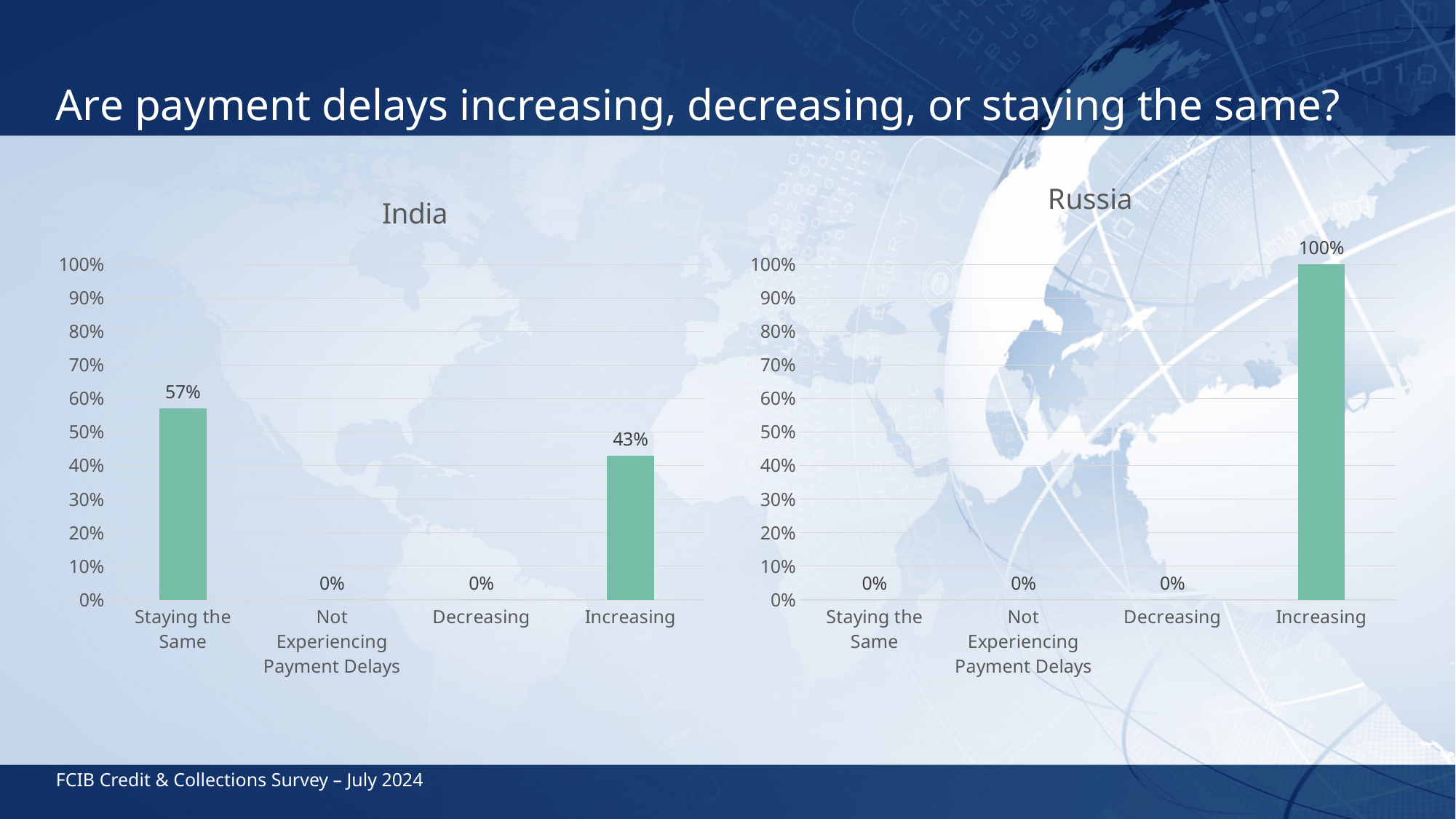
In the Russia chart, what is the value for Decreasing? 0% In the Russia chart, which category has the highest value? Increasing In the Russia chart, what is the value for Increasing? 100% How many categories are shown on the x axis of the Russia chart? 4 What is the title of the chart on the right side of the slide? Russia What kind of chart is the India chart? bar chart In the India chart, what is the value for Increasing? 43% In the India chart, which category has the highest value? Staying the Same In the India chart, is the value for Increasing greater or less than 50%? less In the India chart, which is larger, Staying the Same or Increasing? Staying the Same In the India chart, what is the difference between Staying the Same and Increasing? 14% In the India chart, what is the value for Staying the Same? 57%